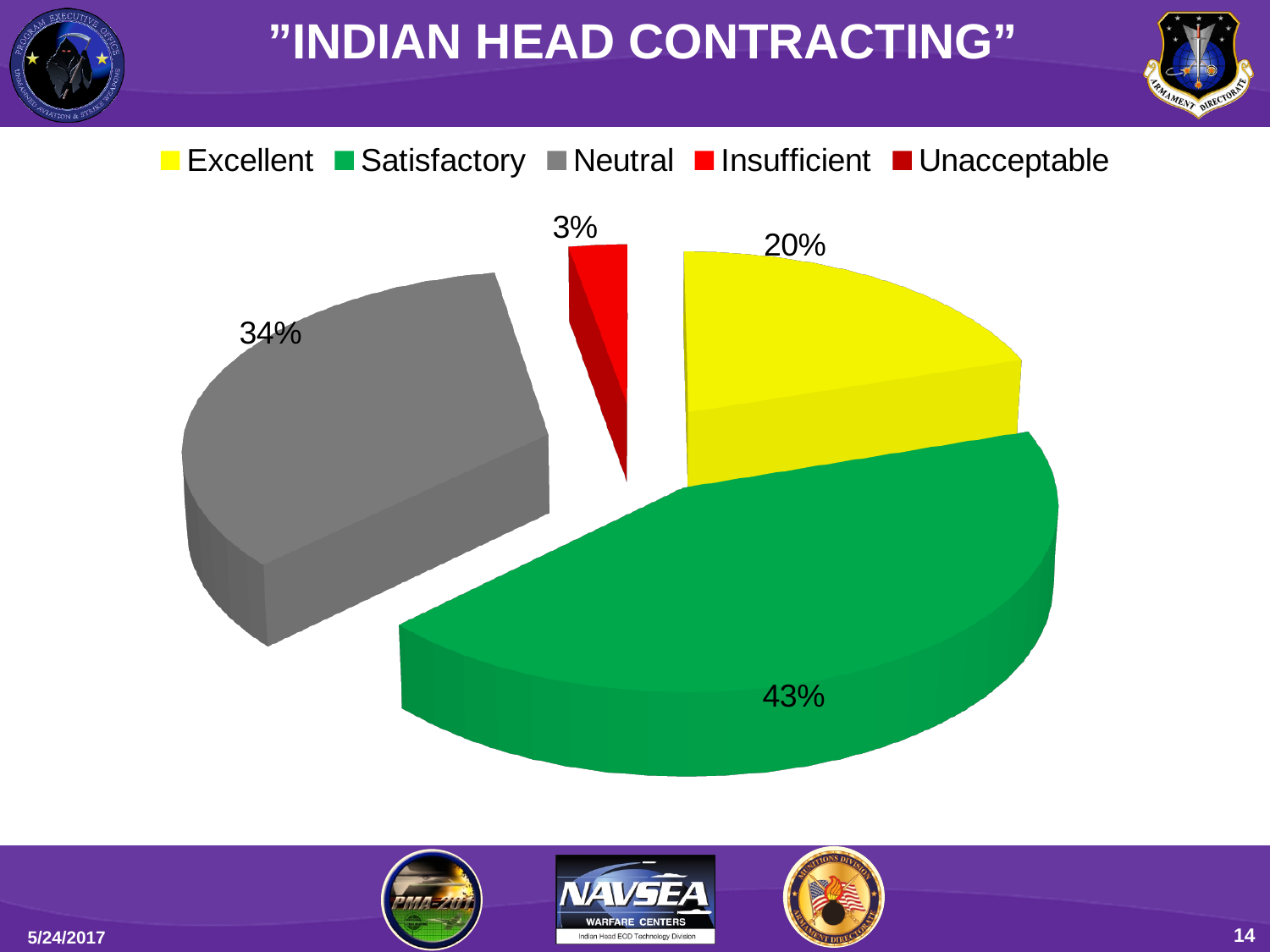
What percentage of the pie is Neutral? 34% What percentage of the pie is Excellent? 20% What percentage is shown on the small red slice of the pie? 3% What type of chart is shown on the slide? pie chart What is the difference between the Neutral and Excellent shares? 14% Which is larger, the Excellent share or the Neutral share? Neutral Which category has the largest share of the pie? Satisfactory What colour represents Satisfactory in the legend? green Which labelled slice has the smallest share of the pie? Insufficient What is the difference between the Satisfactory and Neutral shares? 9% What percentage of the pie is Satisfactory? 43% How many entries does the legend list? 5